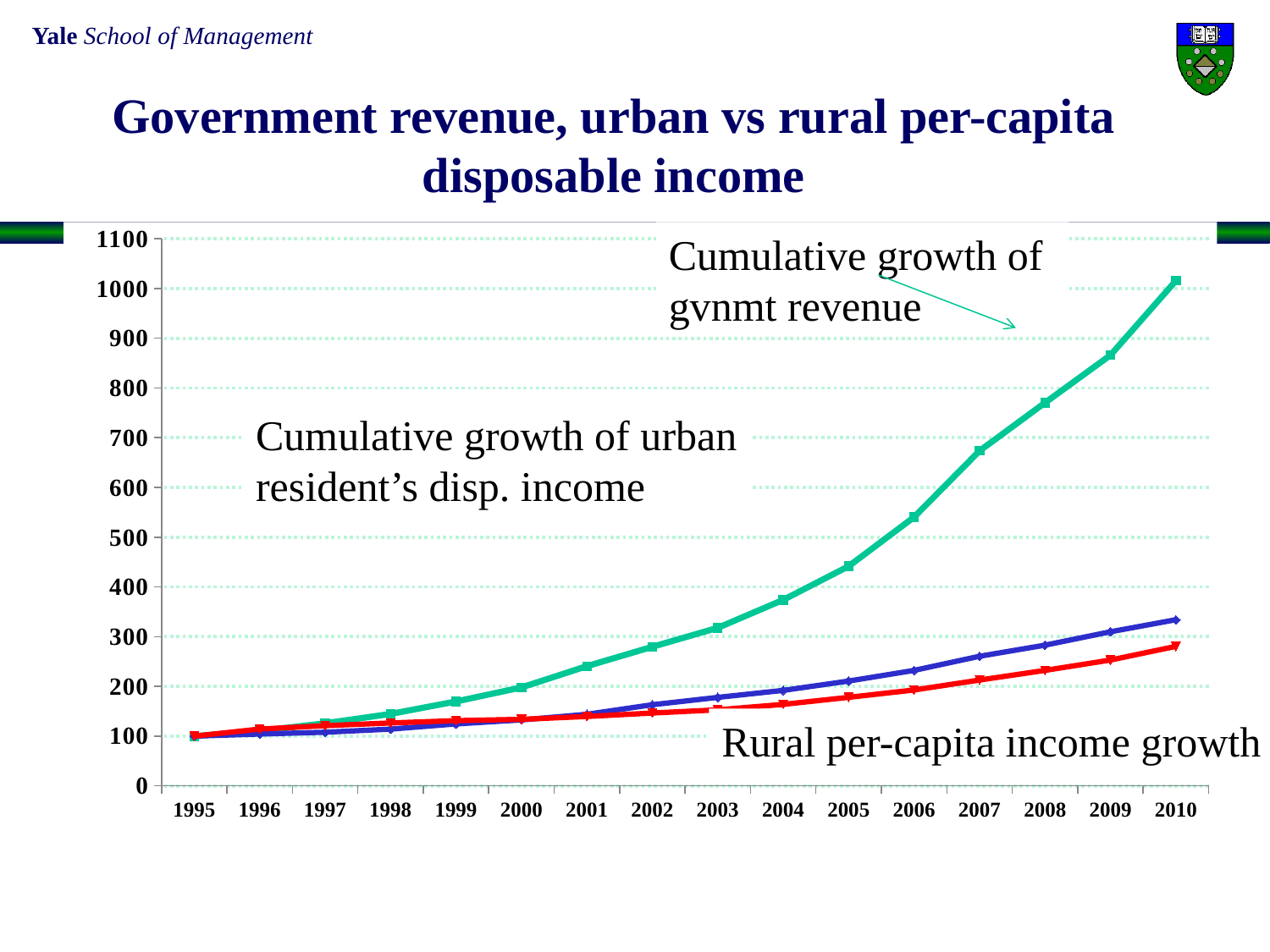
How many data series (lines) are plotted on the chart? 3 What colour is the line for cumulative growth of government revenue? green What is the value of the cumulative growth of government revenue line in 1995? 100 Does the cumulative growth of government revenue line rise or fall from 1995 to 2010? rise What kind of chart is shown on the slide? line chart Which series has the lowest value in 2010? Rural per-capita income growth Is the value for cumulative growth of government revenue in 2007 greater or less than 600? greater Is the value for rural per-capita income growth in 2010 greater or less than 300? less How many years are plotted along the x axis? 16 Which series has the highest value in 2010? Cumulative growth of gvnmt revenue Is the value for cumulative growth of government revenue in 2010 greater or less than 900? greater In 2010, which is larger: cumulative growth of urban resident's disposable income or rural per-capita income growth? Cumulative growth of urban resident's disp. income